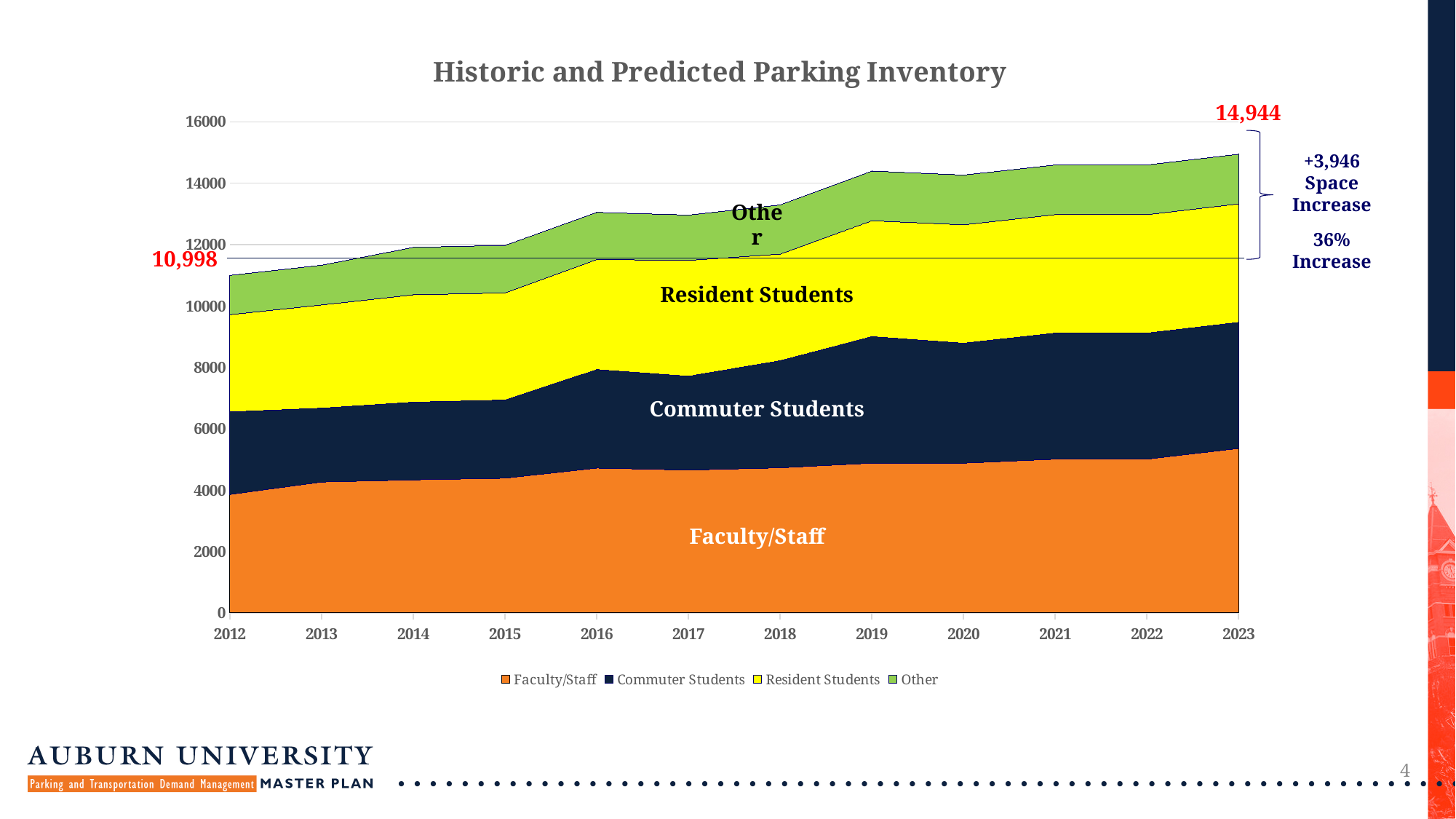
What is the total parking inventory labelled for 2012? 10,998 How many series does the legend list? 4 How many years are shown along the x axis? 12 Does the total parking inventory rise or fall from 2012 to 2023? Rise What is the difference between the 2023 total and the 2012 total? 3,946 Is the total parking inventory in 2019 greater or less than 14000? greater Is the Faculty/Staff value in 2023 greater or less than 4000? greater Which year has the larger total inventory, 2012 or 2023? 2023 What is the title of the chart? Historic and Predicted Parking Inventory What is the total parking inventory labelled for 2023? 14,944 What kind of chart is shown on the slide? Stacked area chart What percentage increase in parking inventory is annotated on the chart? 36%